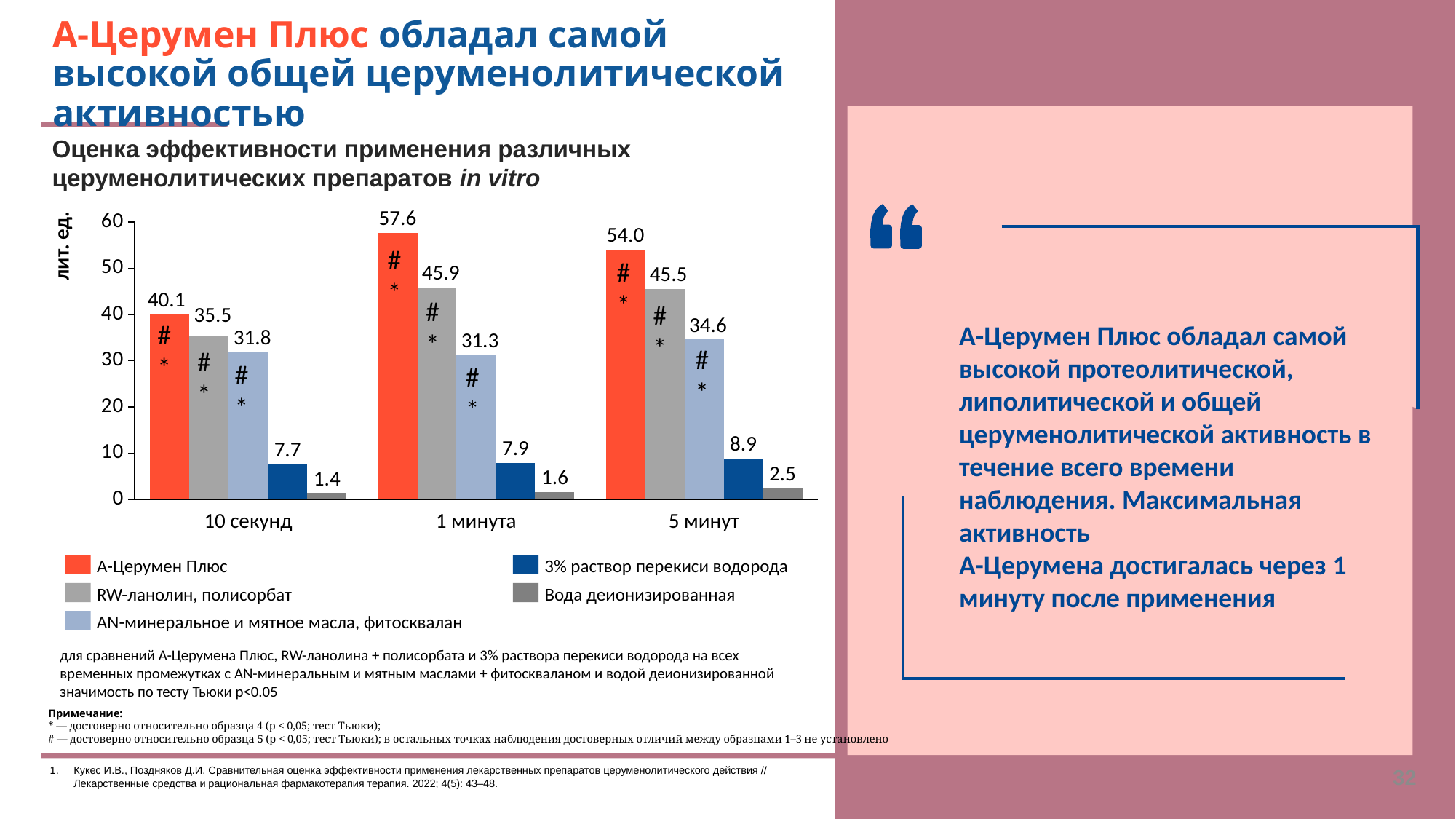
How many series does the legend list? 5 What is the value for А-Церумен Плюс at 1 минута? 57.6 Which series has the lowest value at 1 минута? Вода деионизированная What is the value for 3% раствор перекиси водорода at 5 минут? 8.9 What is the value for Вода деионизированная at 10 секунд? 1.4 What kind of chart is shown on the slide? Bar chart How many time-point categories are shown on the x axis? 3 What is the value for RW-ланолин, полисорбат at 5 минут? 45.5 What is the difference between А-Церумен Плюс and RW-ланолин, полисорбат at 10 секунд? 4.6 Which is larger at 5 минут: AN-минеральное и мятное масла, фитосквалан or 3% раствор перекиси водорода? AN-минеральное и мятное масла, фитосквалан What is the label of the y axis? лит. ед. At which time point does А-Церумен Плюс reach its highest value? 1 минута